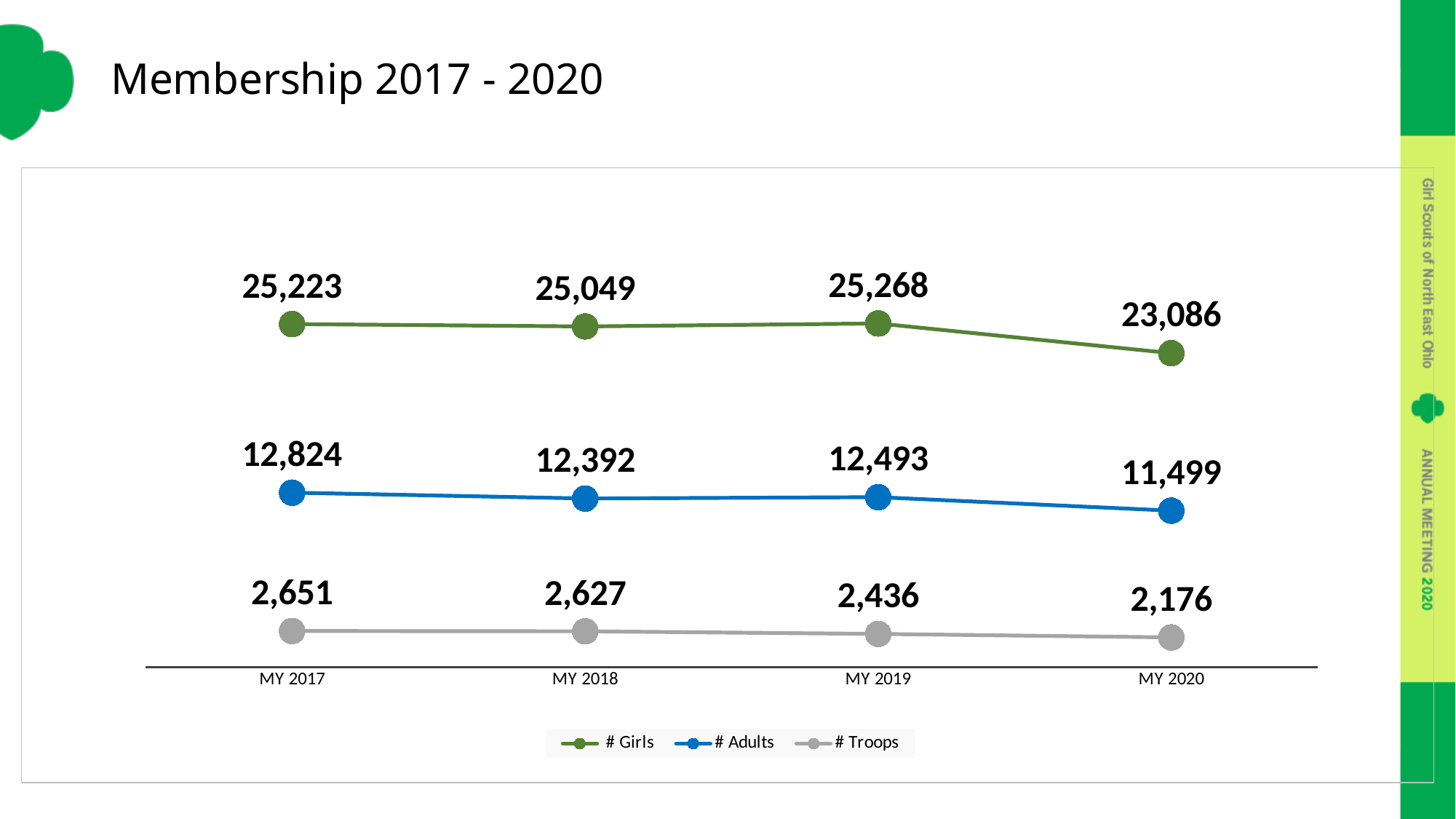
What is the value for # Adults in MY 2020? 11,499 Does the # Troops series rise or fall from MY 2017 to MY 2020? Fall How many series does the legend list? 3 How many years are shown on the x axis? 4 What is the value for # Girls in MY 2019? 25,268 What is the value for # Troops in MY 2018? 2,627 What is the difference between # Adults in MY 2017 and MY 2018? 432 In which year is the # Girls series highest? MY 2019 In which year is the # Troops series lowest? MY 2020 What kind of chart is shown on the slide? Line chart What is the difference between # Girls in MY 2019 and MY 2020? 2,182 Which is larger: # Adults in MY 2018 or # Adults in MY 2019? MY 2019